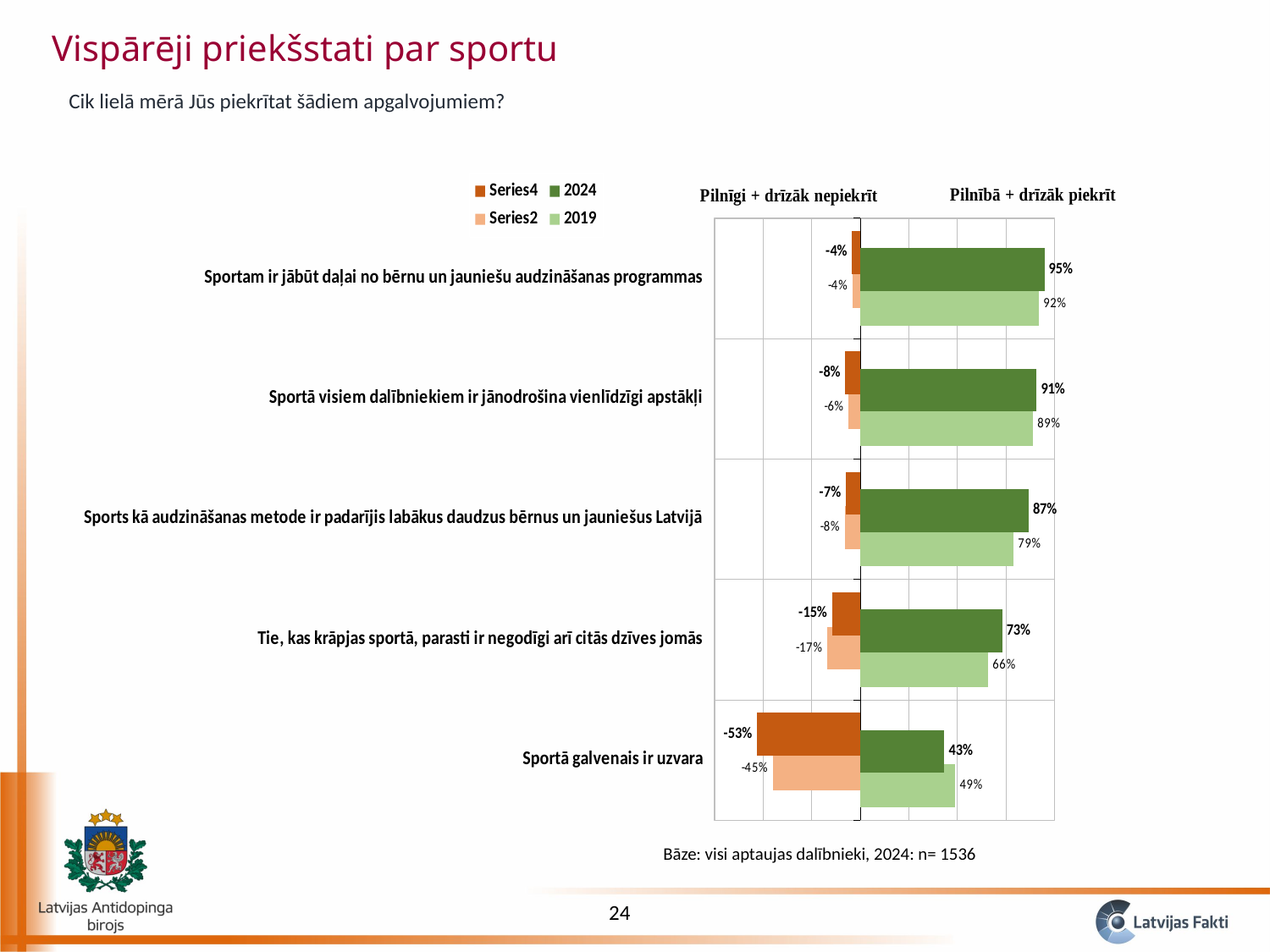
How many series does the legend list? 4 What is the 2024 disagreement value (Pilnīgi + drīzāk nepiekrīt) for "Tie, kas krāpjas sportā, parasti ir negodīgi arī citās dzīves jomās"? -15% What is the difference between the 2024 and 2019 agreement values for "Tie, kas krāpjas sportā, parasti ir negodīgi arī citās dzīves jomās"? 7 percentage points What is the 2019 agreement value for "Sportā galvenais ir uzvara"? 49% What is the 2019 agreement value for "Sports kā audzināšanas metode ir padarījis labākus daudzus bērnus un jauniešus Latvijā"? 79% What kind of chart is shown on the slide? Bar chart What is the 2024 disagreement value for "Sportā galvenais ir uzvara"? -53% For "Sportā galvenais ir uzvara", which is larger: the 2024 agreement value or the 2019 agreement value? 2019 Which statement has the highest 2024 agreement value? Sportam ir jābūt daļai no bērnu un jauniešu audzināšanas programmas Which statement has the lowest 2024 agreement value? Sportā galvenais ir uzvara What is the 2024 agreement value (Pilnībā + drīzāk piekrīt) for "Sportam ir jābūt daļai no bērnu un jauniešu audzināšanas programmas"? 95% How many statements are shown in the chart? 5